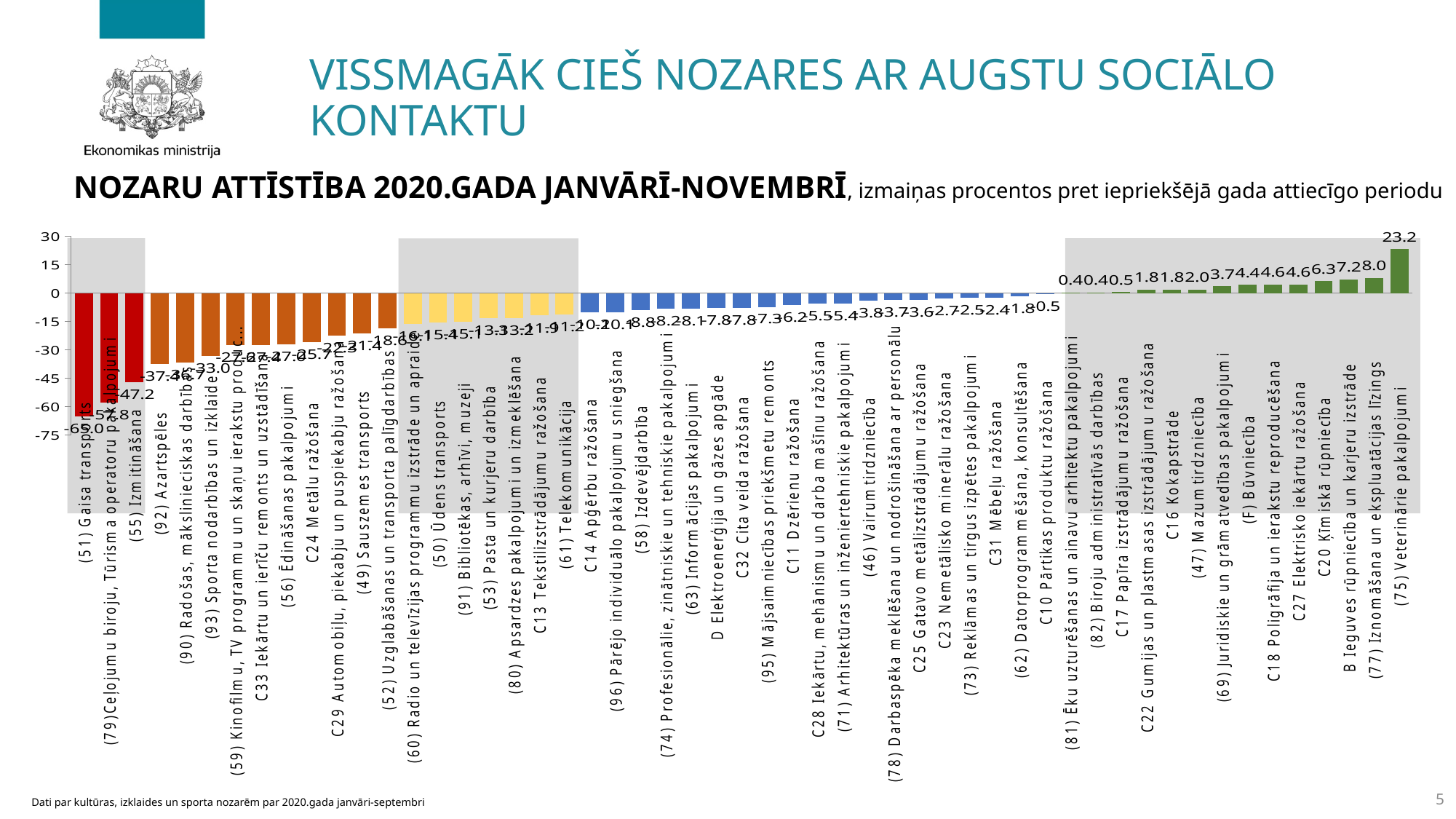
What is the difference between the values for (75) Veterinārie pakalpojumi and (51) Gaisa transports? 88.2 What is the value for (92) Azartspēles? -37.4 What kind of chart is shown on the slide? bar chart Which category has the lowest value? (51) Gaisa transports Which is larger, the value for (92) Azartspēles or the value for (55) Izmitināšana? (92) Azartspēles What colour is the bar for (75) Veterinārie pakalpojumi? green Is the value for (51) Gaisa transports greater or less than -60? less What is the value for (51) Gaisa transports? -65.0 What is the value for (75) Veterinārie pakalpojumi? 23.2 What is the value for (55) Izmitināšana? -47.2 Do the values rise or fall from left to right along the x axis? rise Which category has the highest value? (75) Veterinārie pakalpojumi